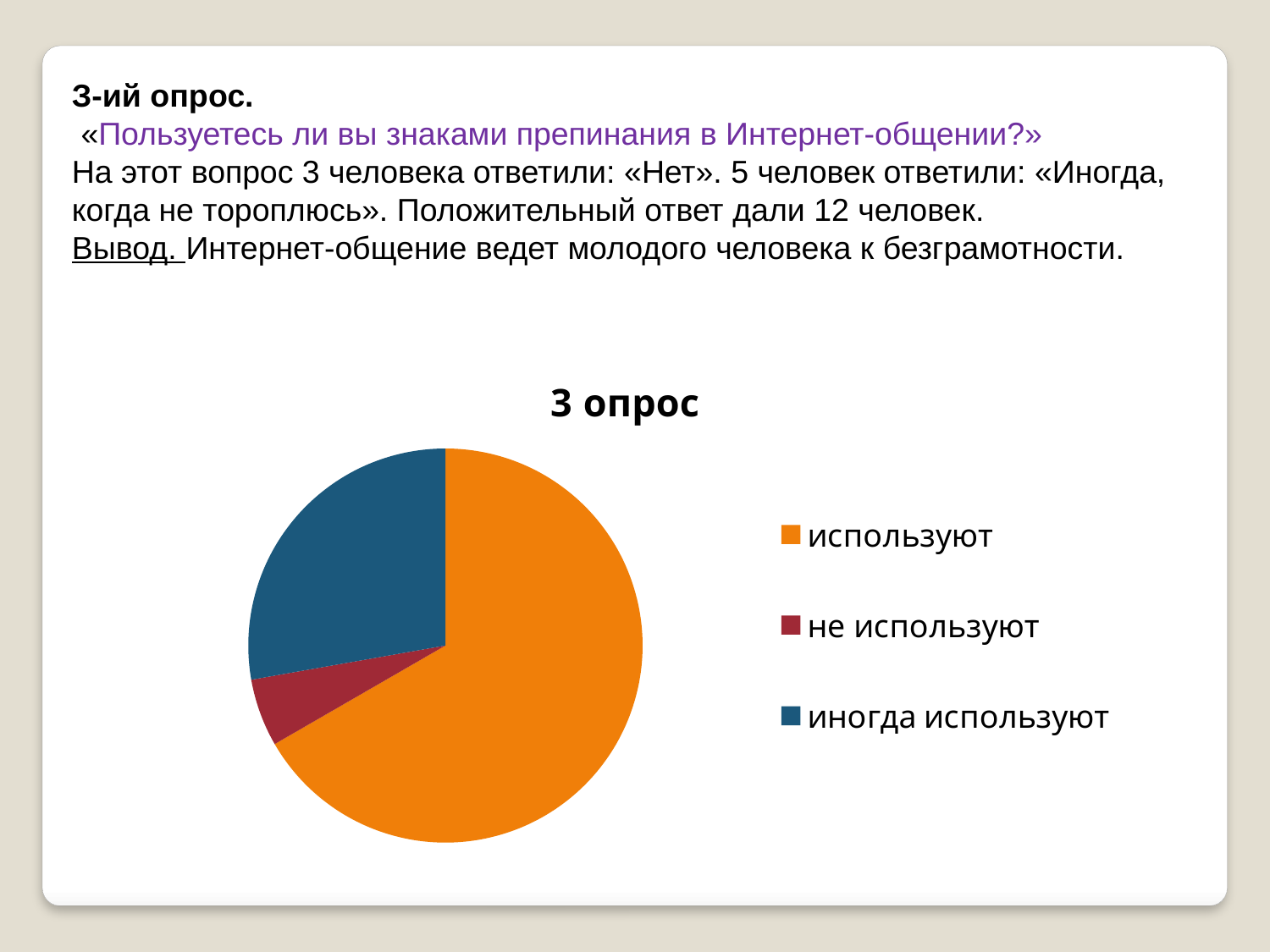
Which category has the smallest slice of the pie? не используют What kind of chart is shown on the slide? pie chart What is the title of the chart? 3 опрос Which category has the largest slice of the pie? используют Which slice is larger: используют or иногда используют? используют How many slices does the pie chart have? 3 Does the используют slice take up more or less than half of the pie? more How many entries does the chart legend list? 3 Which slice is larger: иногда используют or не используют? иногда используют What colour is the slice for используют? orange